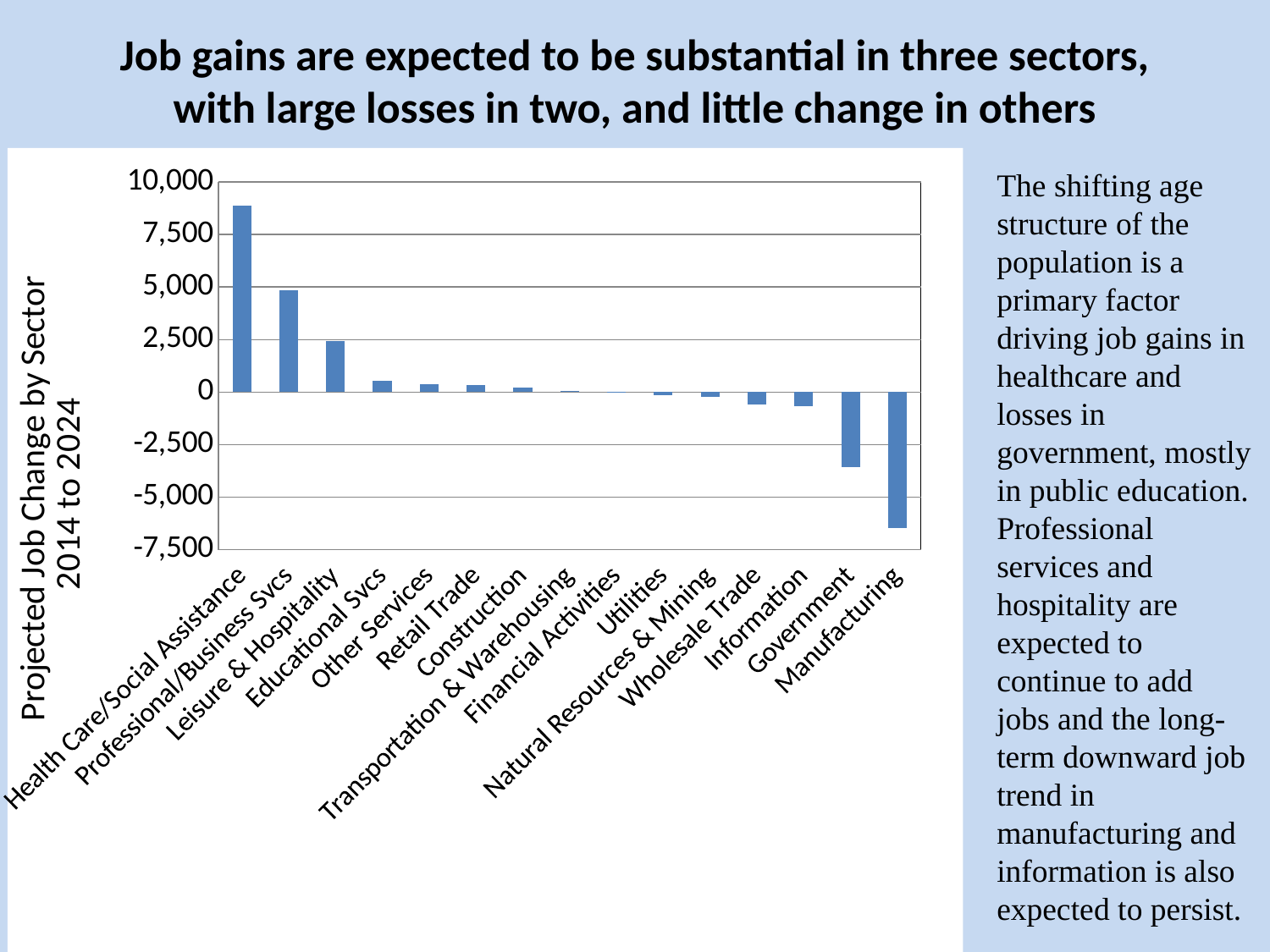
Is the value for Manufacturing greater or less than -5,000? less What is the title of the vertical axis of the chart? Projected Job Change by Sector 2014 to 2024 What kind of chart is shown on the slide? Bar chart Is the value for Professional/Business Svcs greater or less than 5,000? less Is the value for Health Care/Social Assistance greater or less than 7,500? greater Which is larger, the value for Professional/Business Svcs or the value for Leisure & Hospitality? Professional/Business Svcs Do the values generally rise or fall moving from left to right along the x axis? fall Which sector has the lowest projected job change? Manufacturing Which sector has the highest projected job change? Health Care/Social Assistance How many sectors are shown on the x axis of the chart? 15